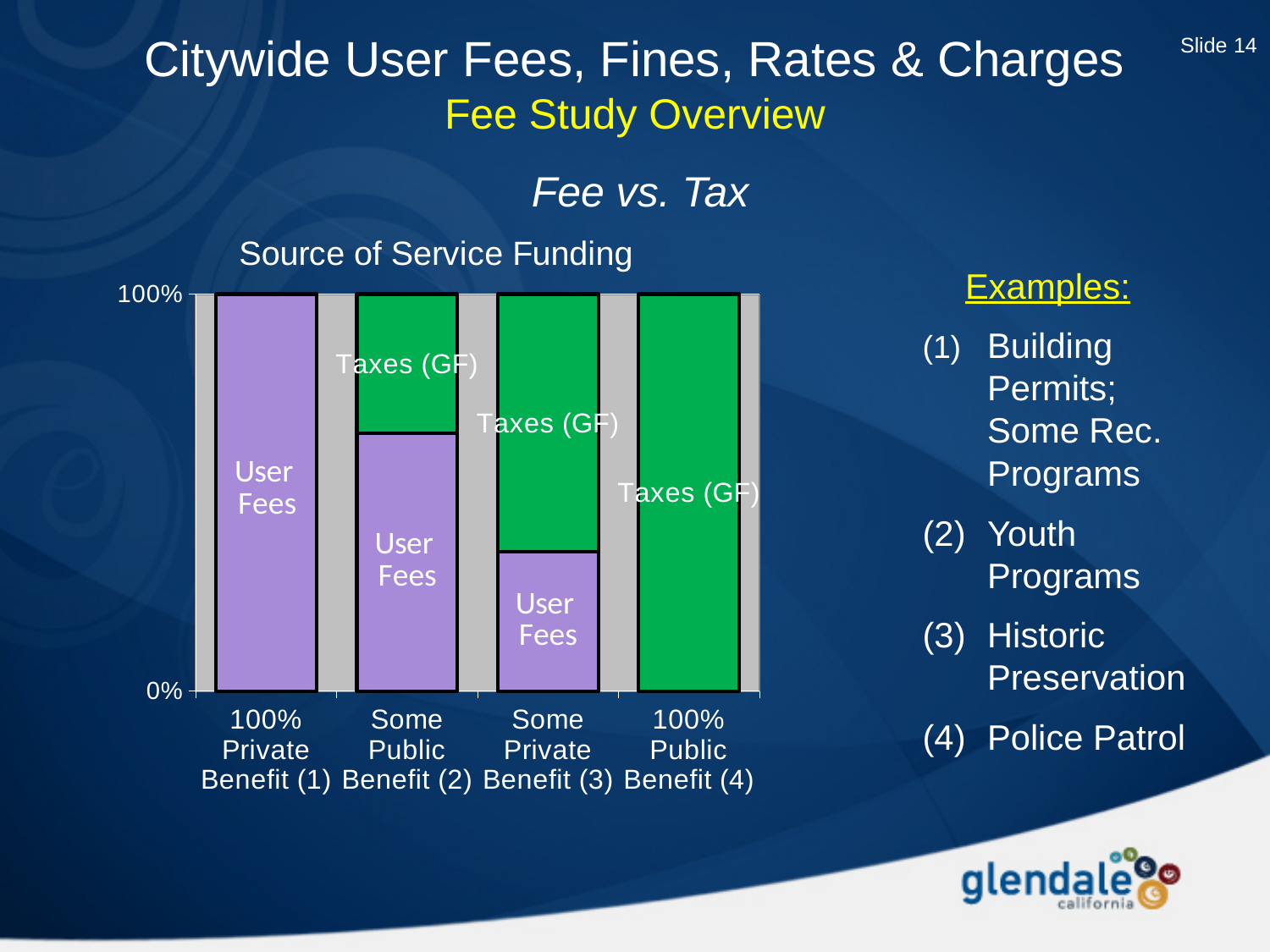
Is the User Fees share for Some Private Benefit (3) greater or less than 50%? less Which has a larger Taxes (GF) share: Some Public Benefit (2) or Some Private Benefit (3)? Some Private Benefit (3) What is the title of the chart? Source of Service Funding What colour represents User Fees in the chart? Purple How many categories are shown along the x axis of the Source of Service Funding chart? 4 Does the User Fees share rise or fall moving from left to right across the categories? Fall Is the User Fees share for Some Public Benefit (2) greater or less than 50%? greater Is the Taxes (GF) share for Some Private Benefit (3) greater or less than 50%? greater What share of funding comes from Taxes (GF) for 100% Public Benefit (4)? 100% Which category has the largest User Fees share? 100% Private Benefit (1) What share of funding comes from User Fees for 100% Private Benefit (1)? 100% What kind of chart is shown under "Source of Service Funding"? Stacked bar chart